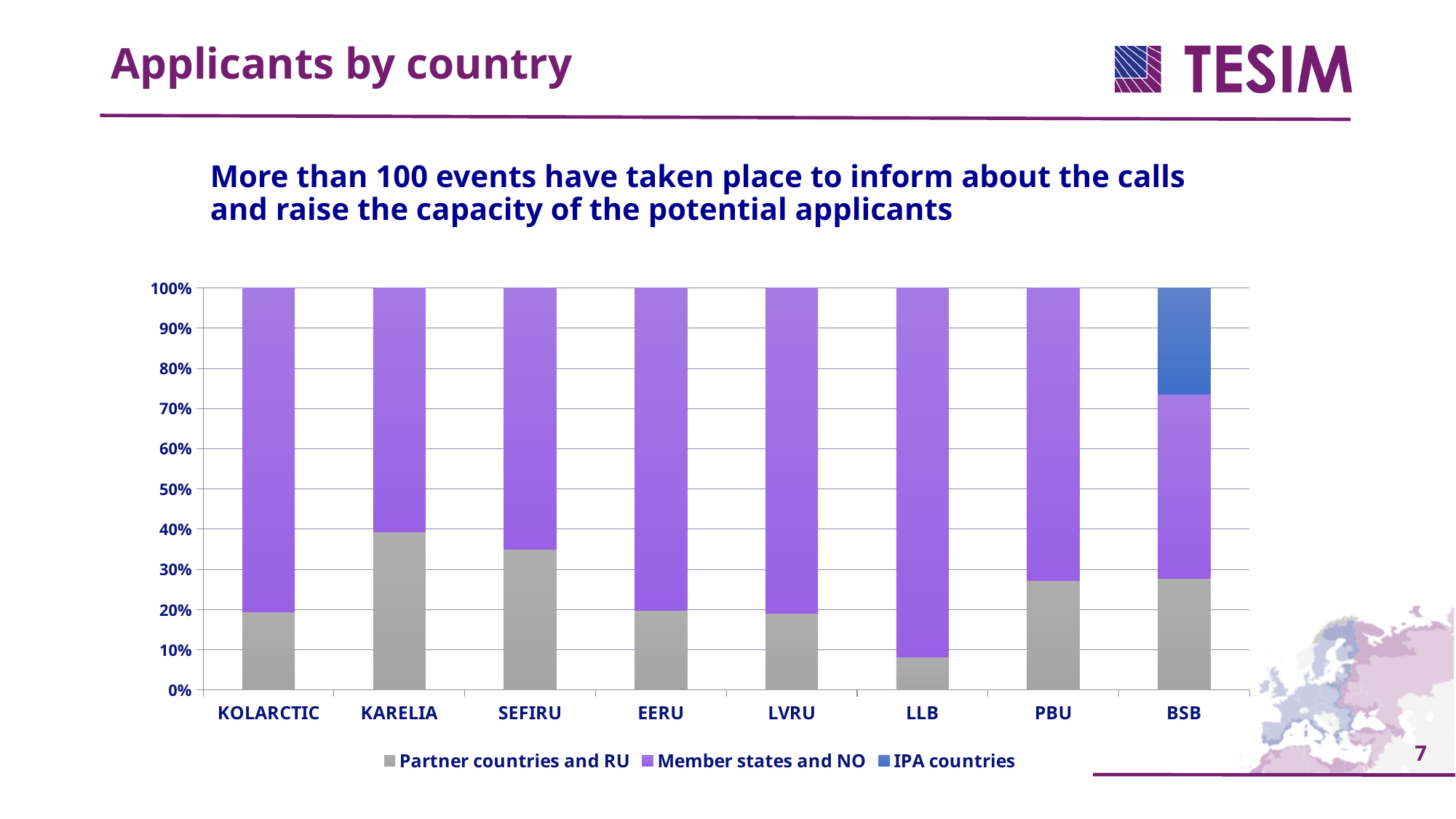
Which category has the smallest share for Partner countries and RU? LLB Is the Partner countries and RU share for LLB greater or less than 10%? less Which has a larger Partner countries and RU share, SEFIRU or EERU? SEFIRU Which category has the largest share for Partner countries and RU? KARELIA Is the Member states and NO share for LLB greater or less than 80%? greater What does each stacked bar in the chart total? 100% How many series does the chart legend list? 3 Is the Partner countries and RU share for KOLARCTIC greater or less than 30%? less Which category is the only one with a share for IPA countries? BSB How many programme categories are shown on the x axis of the chart? 8 What kind of chart is shown on the slide? stacked bar chart